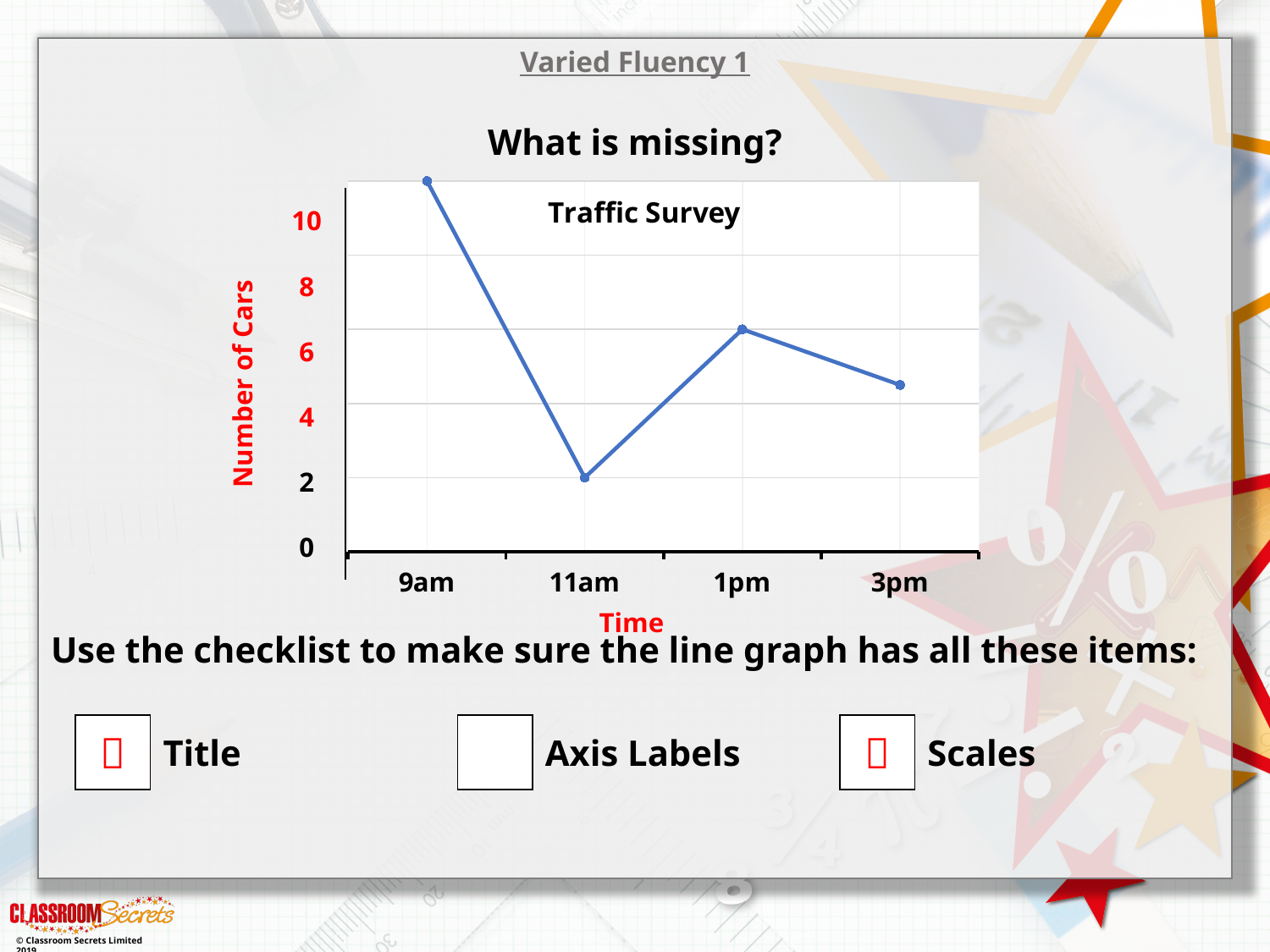
Is the number of cars at 3pm greater or less than 6? less What is the number of cars at 11am? 2 What is the label on the vertical axis of the chart? Number of Cars Which has more cars, 1pm or 3pm? 1pm Does the number of cars rise or fall from 9am to 11am? fall How many time points are plotted on the chart? 4 At which time is the number of cars highest? 9am At which time is the number of cars lowest? 11am What type of chart is shown on the slide? line chart What is the title of the chart? Traffic Survey